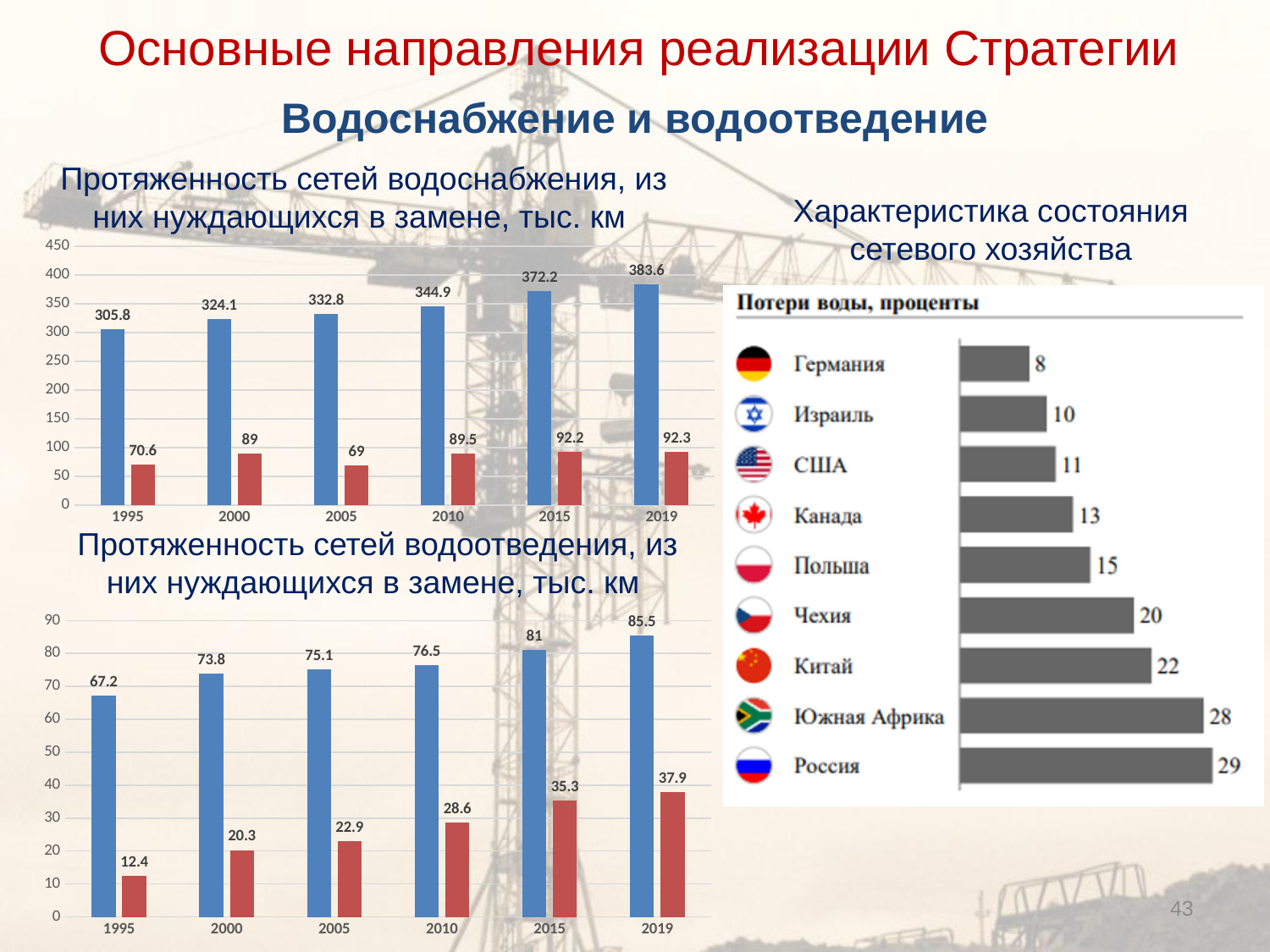
In the bottom-left chart (Протяженность сетей водоотведения), how many years are shown on the x axis? 6 In the bottom-left chart (Протяженность сетей водоотведения), which year has the highest blue bar? 2019 In the right chart (Потери воды, проценты), which is larger, the value for Китай or the value for Польша? Китай In the top-left chart (Протяженность сетей водоснабжения), what is the value of the blue bar for 2019? 383.6 In the bottom-left chart (Протяженность сетей водоотведения), what is the value of the red bar for 2010? 28.6 In the top-left chart (Протяженность сетей водоснабжения), what is the value of the red bar for 1995? 70.6 In the right chart (Потери воды, проценты), which country has the lowest value? Германия In the bottom-left chart (Протяженность сетей водоотведения), what is the difference between the red bar values for 2019 and 1995? 25.5 In the right chart (Потери воды, проценты), what is the value for Россия? 29 In the top-left chart (Протяженность сетей водоснабжения), which year has the lowest red bar? 2005 In the top-left chart (Протяженность сетей водоснабжения), do the blue bar values rise or fall from 1995 to 2019? rise In the top-left chart (Протяженность сетей водоснабжения), what is the difference between the blue bar values for 2019 and 1995? 77.8